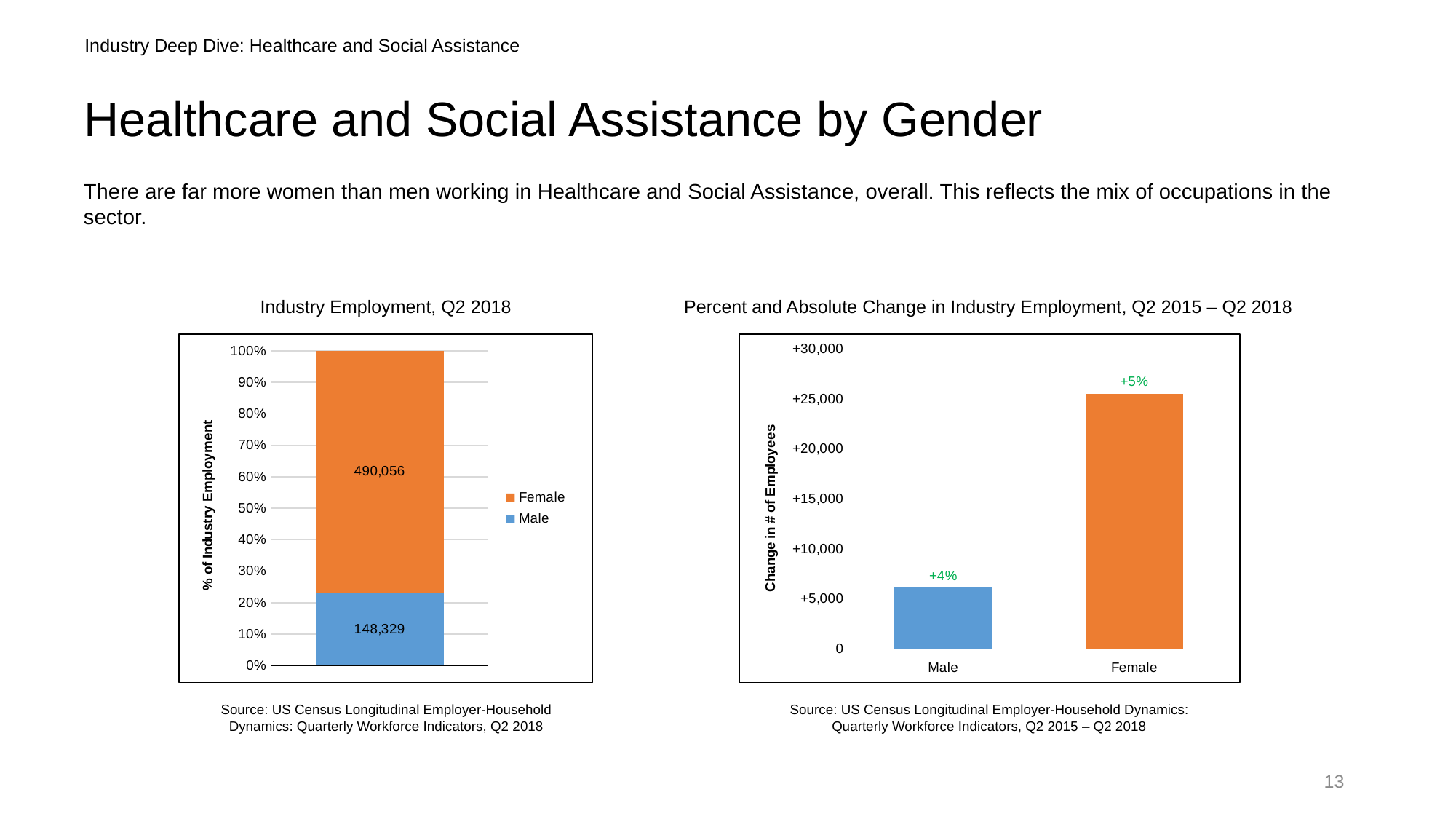
In the 'Industry Employment, Q2 2018' chart, what is the value shown for Female? 490,056 In the 'Percent and Absolute Change in Industry Employment, Q2 2015 – Q2 2018' chart, is the change in number of employees for Female greater or less than +20,000? greater In the 'Percent and Absolute Change in Industry Employment, Q2 2015 – Q2 2018' chart, what percent change is labelled for Female? +5% In the 'Industry Employment, Q2 2018' chart, what is the label on the vertical axis? % of Industry Employment In the 'Industry Employment, Q2 2018' chart, which series has the larger value, Female or Male? Female In the 'Percent and Absolute Change in Industry Employment, Q2 2015 – Q2 2018' chart, is the change in number of employees for Male greater or less than +10,000? less In the 'Industry Employment, Q2 2018' chart, what is the value shown for Male? 148,329 In the 'Industry Employment, Q2 2018' chart, how many series does the legend list? 2 In the 'Percent and Absolute Change in Industry Employment, Q2 2015 – Q2 2018' chart, what percent change is labelled for Male? +4% In the 'Industry Employment, Q2 2018' chart, what is the total of the Female and Male values in the stacked bar? 638,385 In the 'Industry Employment, Q2 2018' chart, what is the difference between the Female and Male values? 341,727 In the 'Percent and Absolute Change in Industry Employment, Q2 2015 – Q2 2018' chart, which category has the highest change in number of employees? Female